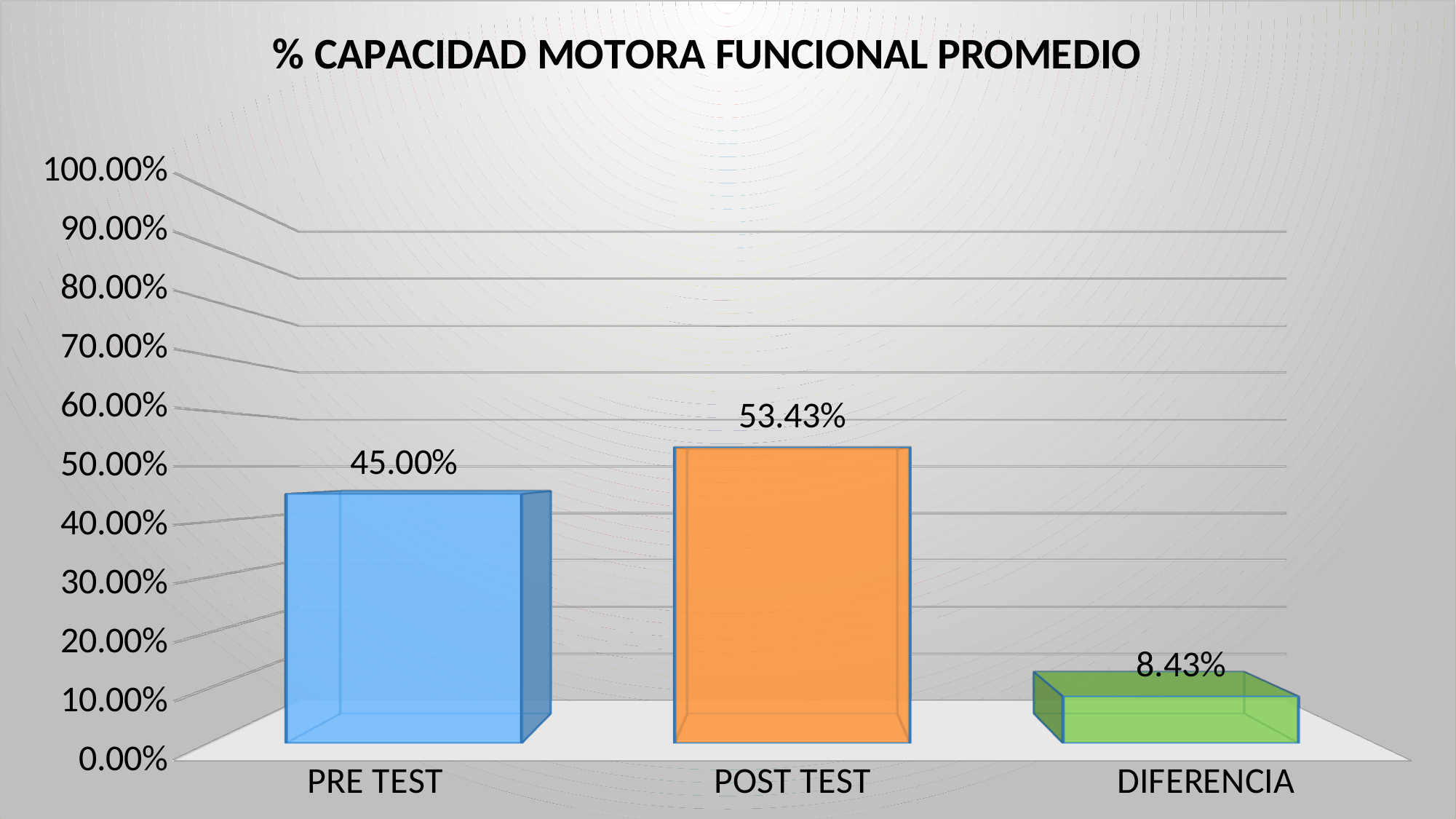
Which is larger, the value for PRE TEST or the value for POST TEST? POST TEST What is the value for POST TEST? 53.43% What is the title of the chart? % CAPACIDAD MOTORA FUNCIONAL PROMEDIO Is the value for POST TEST greater or less than 50.00%? greater What is the difference between the POST TEST and PRE TEST values? 8.43% How many categories are shown on the x axis? 3 Is the value for DIFERENCIA greater or less than 10.00%? less Which category has the highest value? POST TEST Which category has the lowest value? DIFERENCIA What is the value for PRE TEST? 45.00% What is the value for DIFERENCIA? 8.43% What kind of chart is shown on the slide? bar chart